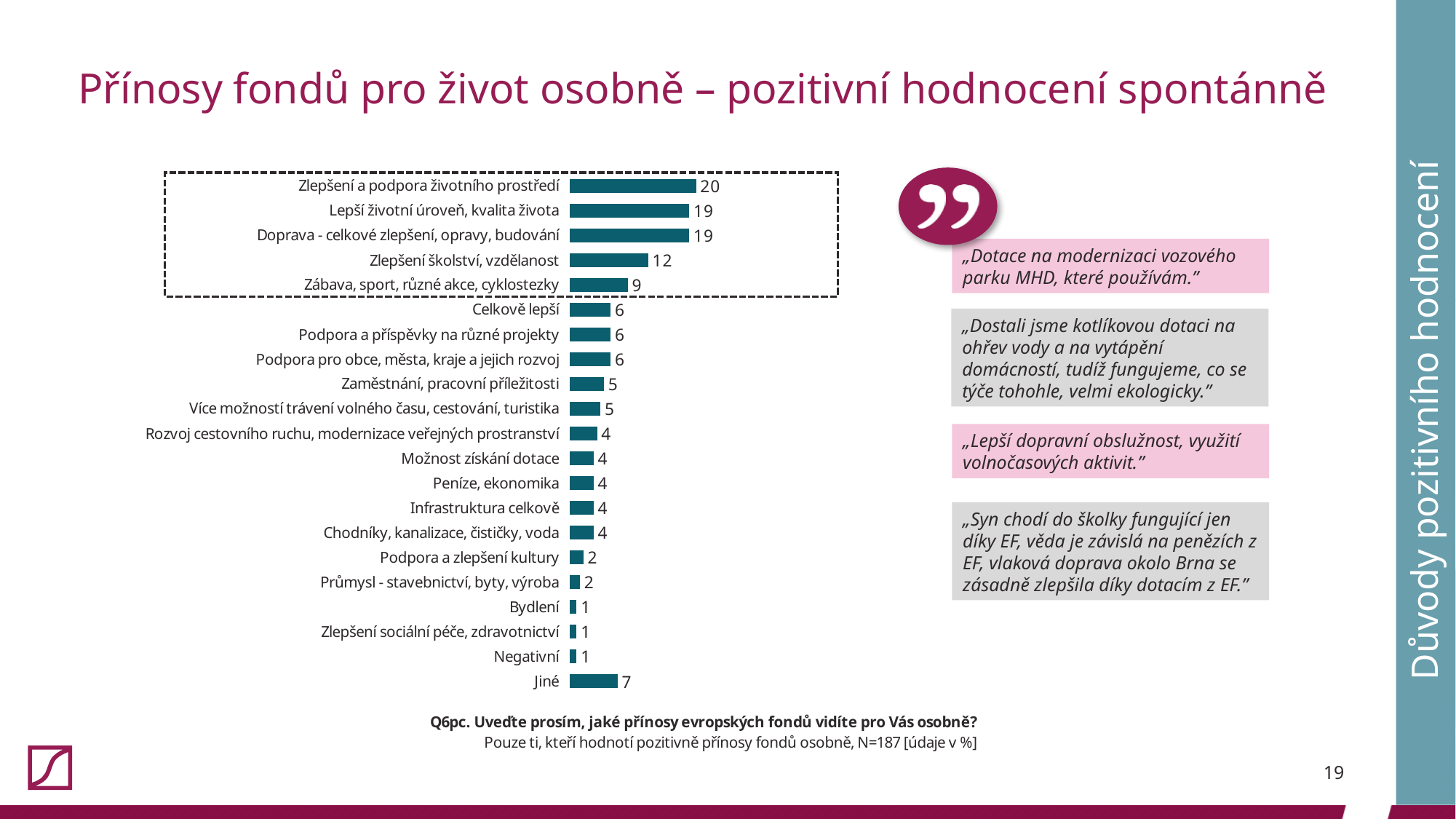
Which category has the highest value? Zlepšení a podpora životního prostředí What value is shown for "Zlepšení školství, vzdělanost"? 12 What is the difference between the values for "Jiné" and "Celkově lepší"? 1 What value is shown for "Zábava, sport, různé akce, cyklostezky"? 9 What is the lowest value shown on the chart? 1 What value is shown for "Jiné"? 7 Which is larger, the value for "Jiné" or the value for "Zábava, sport, různé akce, cyklostezky"? Zábava, sport, různé akce, cyklostezky What kind of chart is shown on the slide? Bar chart How many categories are shown on the chart? 21 How many categories are enclosed in the dashed box at the top of the chart? 5 Which is larger, the value for "Zaměstnání, pracovní příležitosti" or the value for "Podpora a zlepšení kultury"? Zaměstnání, pracovní příležitosti What is the difference between the values for "Zlepšení a podpora životního prostředí" and "Zlepšení školství, vzdělanost"? 8